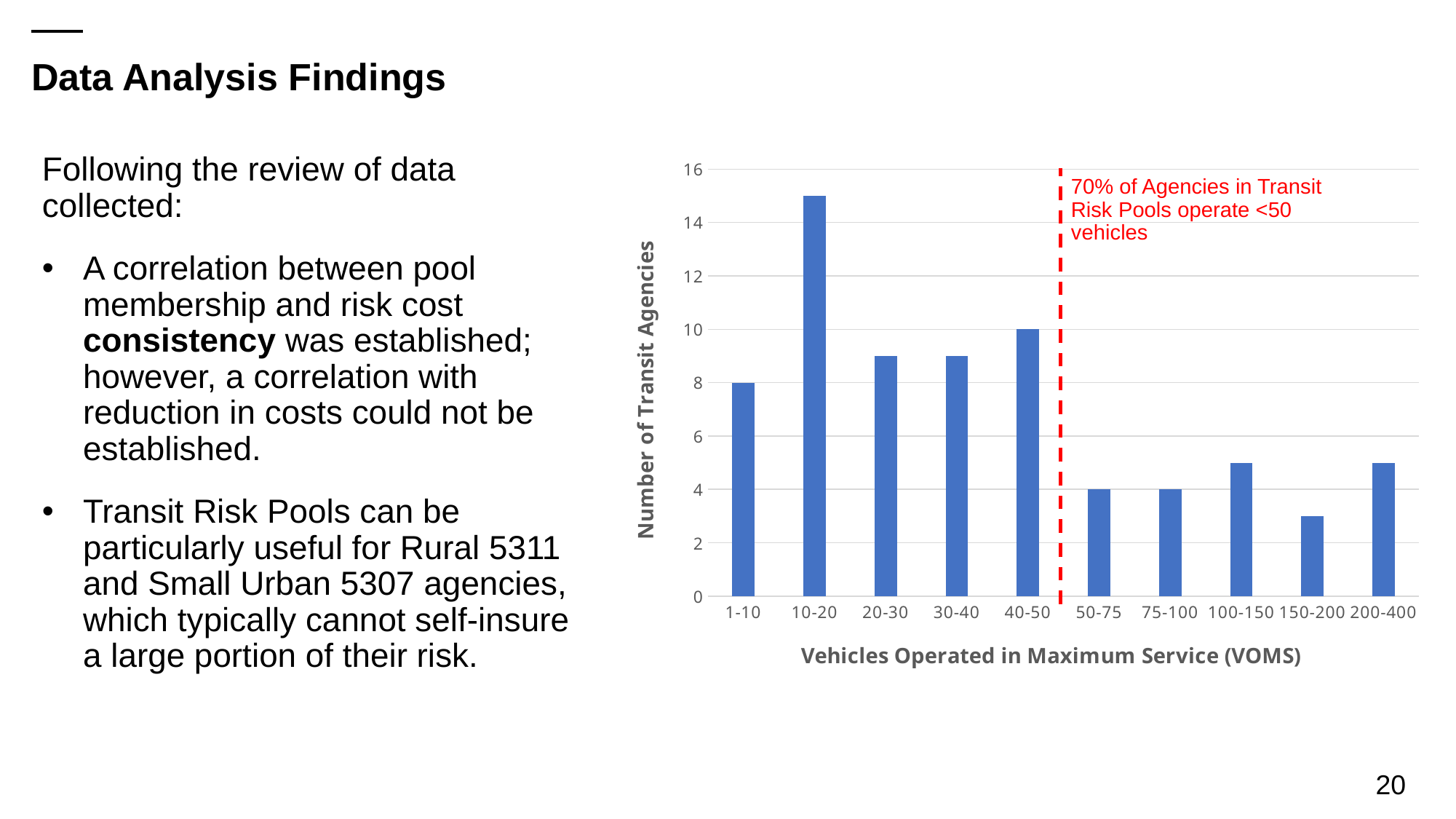
What is the title of the x axis of the chart? Vehicles Operated in Maximum Service (VOMS) Which VOMS category has the highest number of transit agencies? 10-20 Is the number of transit agencies for the 150-200 VOMS category greater or less than 4? less Which VOMS category has the lowest number of transit agencies? 150-200 How many VOMS categories are shown on the x axis of the chart? 10 What is the difference in the number of transit agencies between the 40-50 and 1-10 VOMS categories? 2 How many transit agencies are in the 50-75 VOMS category? 4 Is the number of transit agencies for the 10-20 VOMS category greater or less than 14? greater What kind of chart is shown on the slide? bar chart Which has more transit agencies, the 10-20 or the 40-50 VOMS category? 10-20 How many transit agencies are in the 40-50 VOMS category? 10 How many transit agencies are in the 1-10 VOMS category? 8